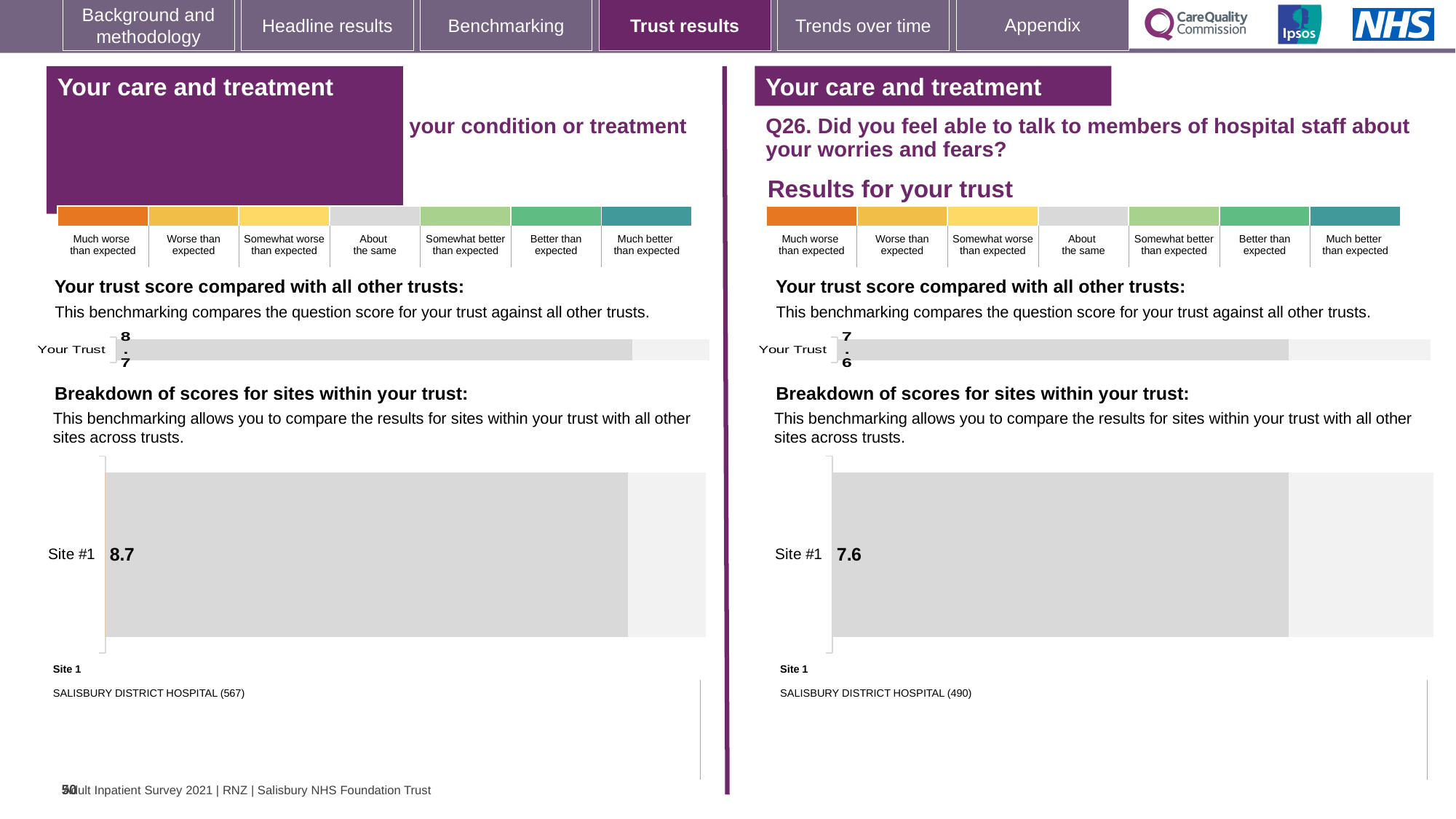
On the left panel's 'Your trust score compared with all other trusts' chart, what is the value for Your Trust? 8.7 What is the difference between the Site #1 score on the left panel and the Site #1 score on the right panel (Q26)? 1.1 What type of chart is used for the 'Breakdown of scores for sites within your trust' on the right panel (Q26)? Bar chart On the right panel (Q26) 'Your trust score compared with all other trusts' chart, what is the value for Your Trust? 7.6 On the left panel's 'Breakdown of scores for sites within your trust' chart, what is the score for Site #1? 8.7 Which site is listed as Site 1 below the right panel's (Q26) site breakdown chart? SALISBURY DISTRICT HOSPITAL (490) On the right panel (Q26) 'Breakdown of scores for sites within your trust' chart, what is the score for Site #1? 7.6 How many bars are plotted in the left panel's 'Your trust score compared with all other trusts' chart? 1 How many categories does the colour scale above the left panel's charts show, from 'Much worse than expected' to 'Much better than expected'? 7 How many sites are shown in the right panel's (Q26) 'Breakdown of scores for sites within your trust' chart? 1 What type of chart is used for 'Your trust score compared with all other trusts' on the left panel? Bar chart Which is larger: the Your Trust score on the left panel or the Your Trust score on the right panel (Q26)? Left panel